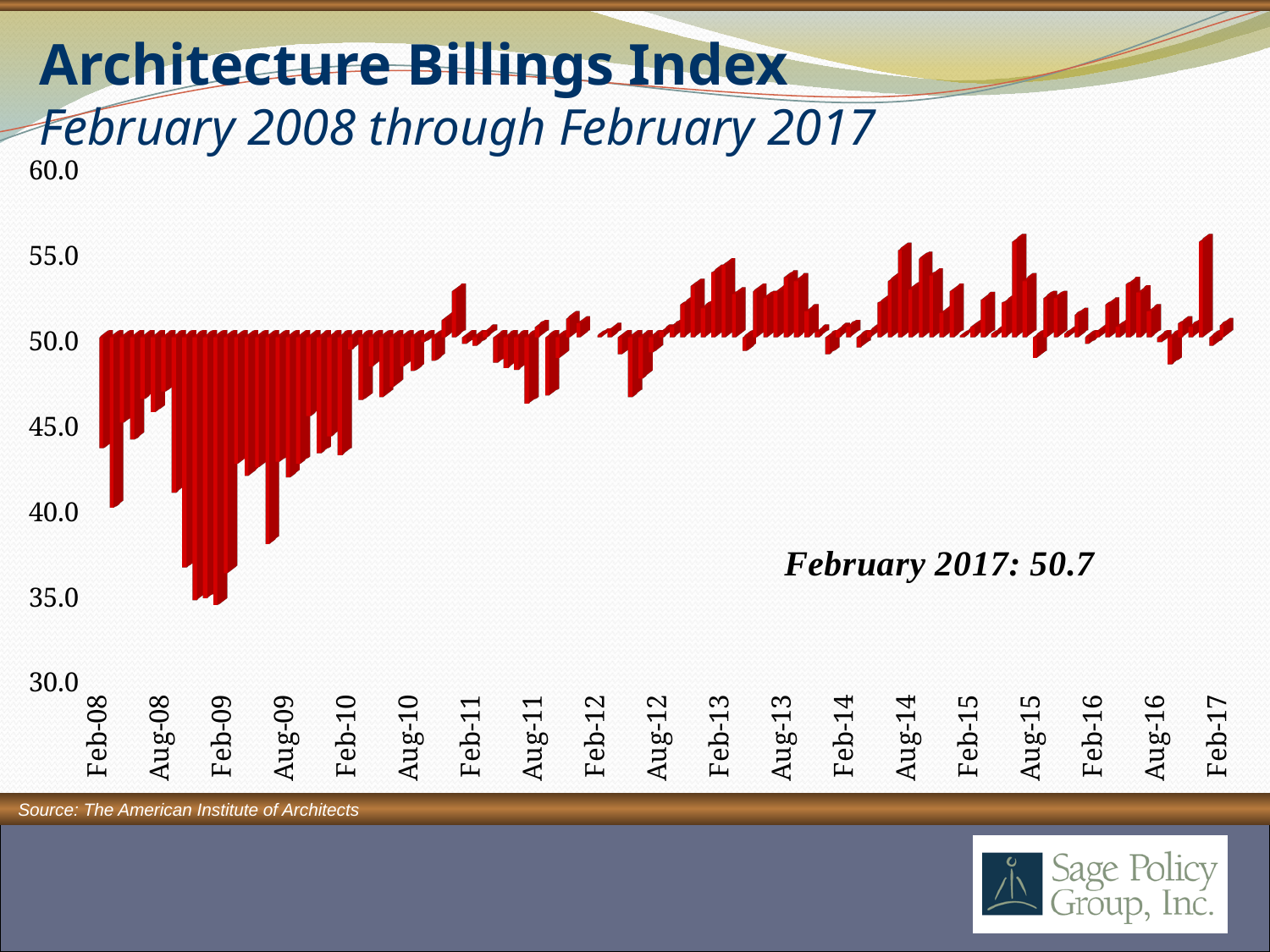
Do the values rise or fall between Feb-09 and Feb-10? rise Is the value for Feb-13 greater or less than 50.0? greater What is the title of the chart? Architecture Billings Index What source is cited for the chart data? The American Institute of Architects What kind of chart is shown on the slide? Bar chart What is the value of the Architecture Billings Index for February 2017? 50.7 Around which x-axis label does the index reach its lowest values? Feb-09 What is the highest value shown on the y axis? 60.0 Is the value for Feb-09 greater or less than 40.0? less Is the value for February 2017 greater or less than 50.0? greater How many labels are shown on the x axis? 19